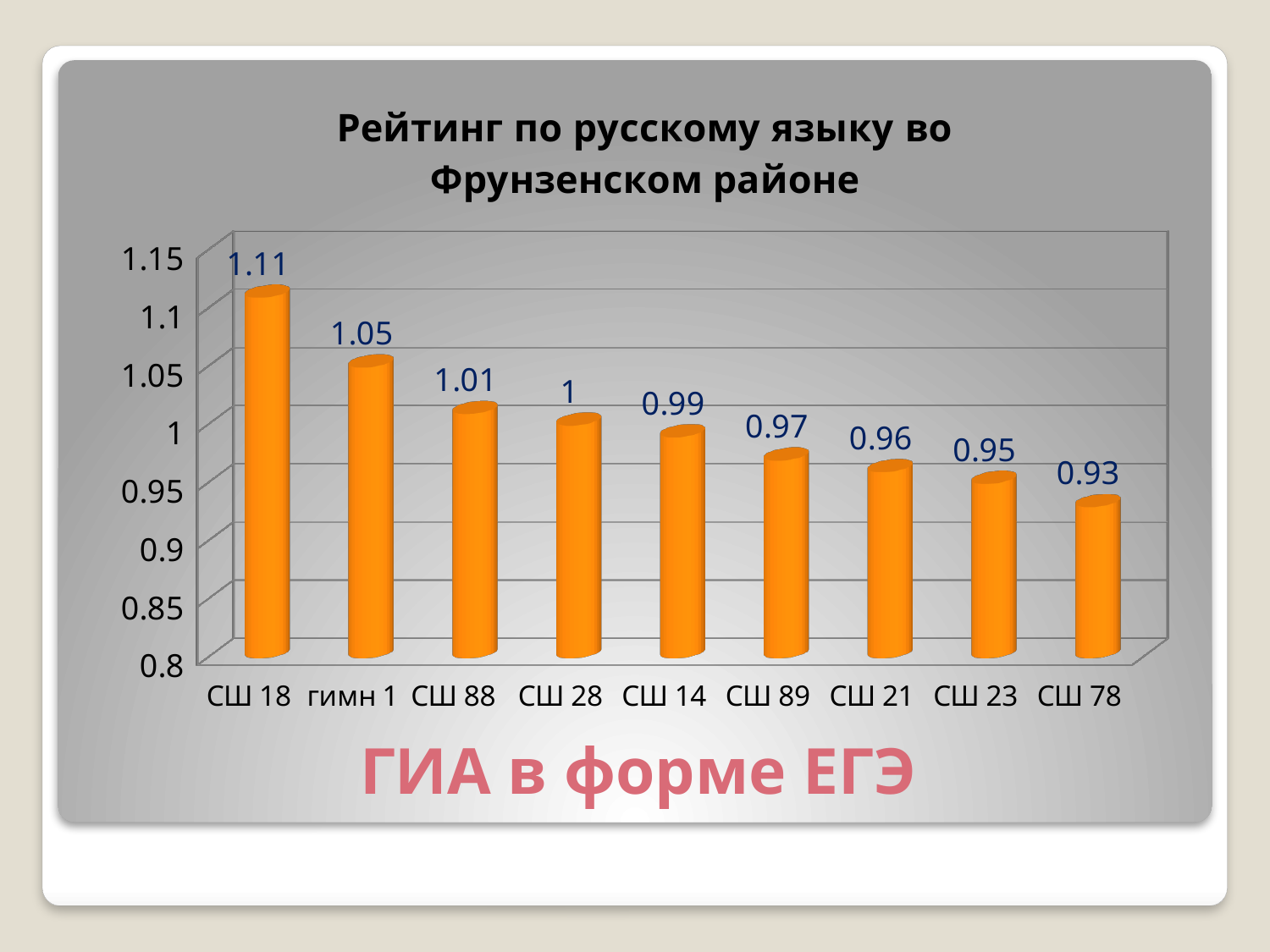
Do the values rise or fall from left to right along the x axis? fall What kind of chart is shown on the slide? bar chart Which category has the lowest value? СШ 78 How many categories are shown on the x axis? 9 What is the value for гимн 1? 1.05 What is the difference between the values for СШ 18 and СШ 78? 0.18 What is the value for СШ 18? 1.11 Which is larger, the value for СШ 88 or the value for СШ 14? СШ 88 Is the value for СШ 21 greater or less than 1? less What is the value for СШ 78? 0.93 Which category has the highest value? СШ 18 What is the value for СШ 89? 0.97